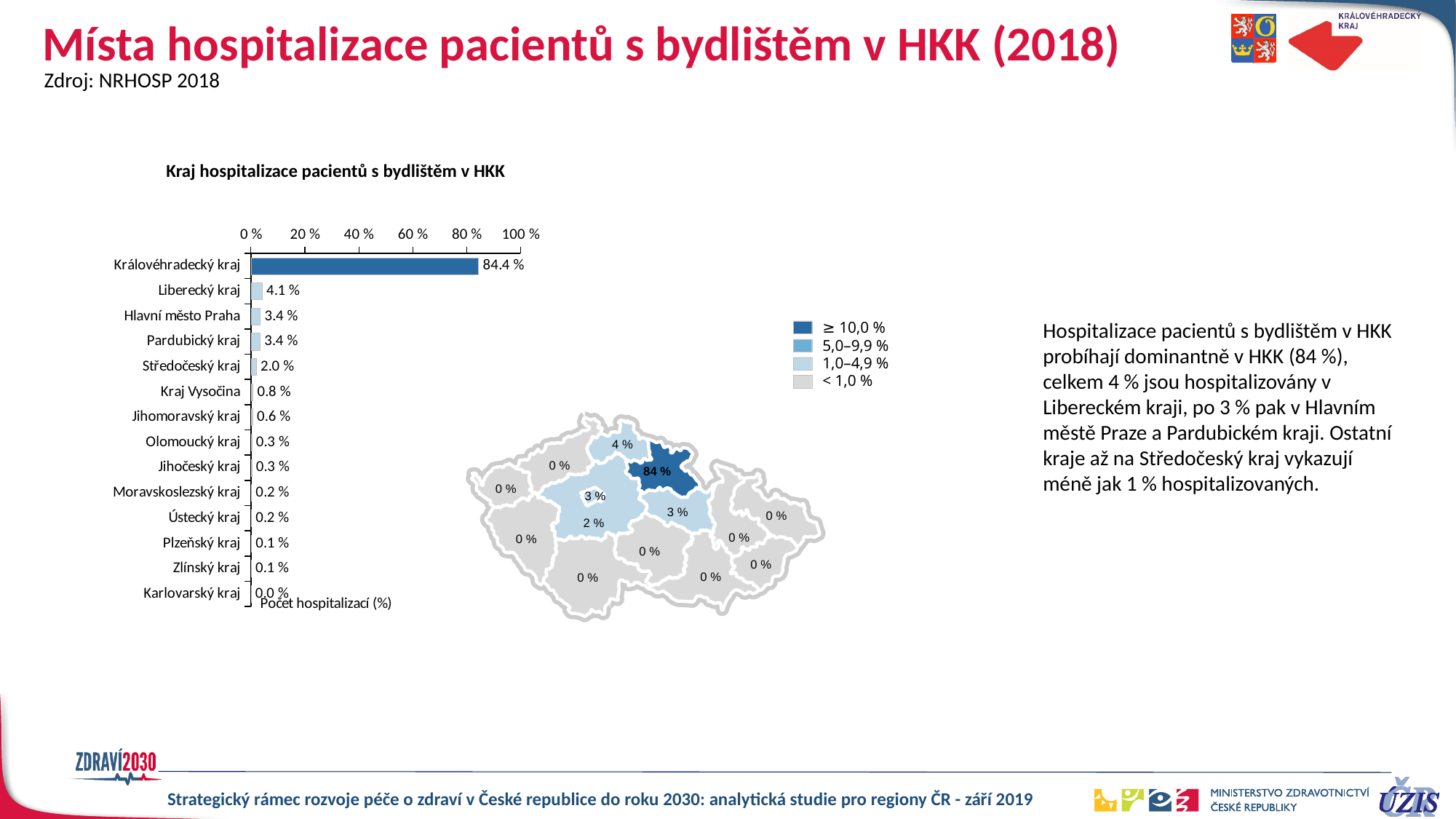
In the chart 'Kraj hospitalizace pacientů s bydlištěm v HKK', which is larger, the value for Liberecký kraj or the value for Pardubický kraj? Liberecký kraj In the chart 'Kraj hospitalizace pacientů s bydlištěm v HKK', which region has the lowest value? Karlovarský kraj In the chart 'Kraj hospitalizace pacientů s bydlištěm v HKK', is the value for Královéhradecký kraj greater or less than 80 %? greater How many regions are listed in the chart 'Kraj hospitalizace pacientů s bydlištěm v HKK'? 14 In the chart 'Kraj hospitalizace pacientů s bydlištěm v HKK', which region has the highest value? Královéhradecký kraj In the chart 'Kraj hospitalizace pacientů s bydlištěm v HKK', what is the difference between the values for Královéhradecký kraj and Liberecký kraj? 80.3 % What is the x-axis label of the chart 'Kraj hospitalizace pacientů s bydlištěm v HKK'? Počet hospitalizací (%) In the chart 'Kraj hospitalizace pacientů s bydlištěm v HKK', what is the value for Kraj Vysočina? 0.8 % In the chart 'Kraj hospitalizace pacientů s bydlištěm v HKK', what is the value for Středočeský kraj? 2.0 % In the chart 'Kraj hospitalizace pacientů s bydlištěm v HKK', what is the value for Královéhradecký kraj? 84.4 % What kind of chart is 'Kraj hospitalizace pacientů s bydlištěm v HKK'? bar chart In the chart 'Kraj hospitalizace pacientů s bydlištěm v HKK', what is the value for Liberecký kraj? 4.1 %